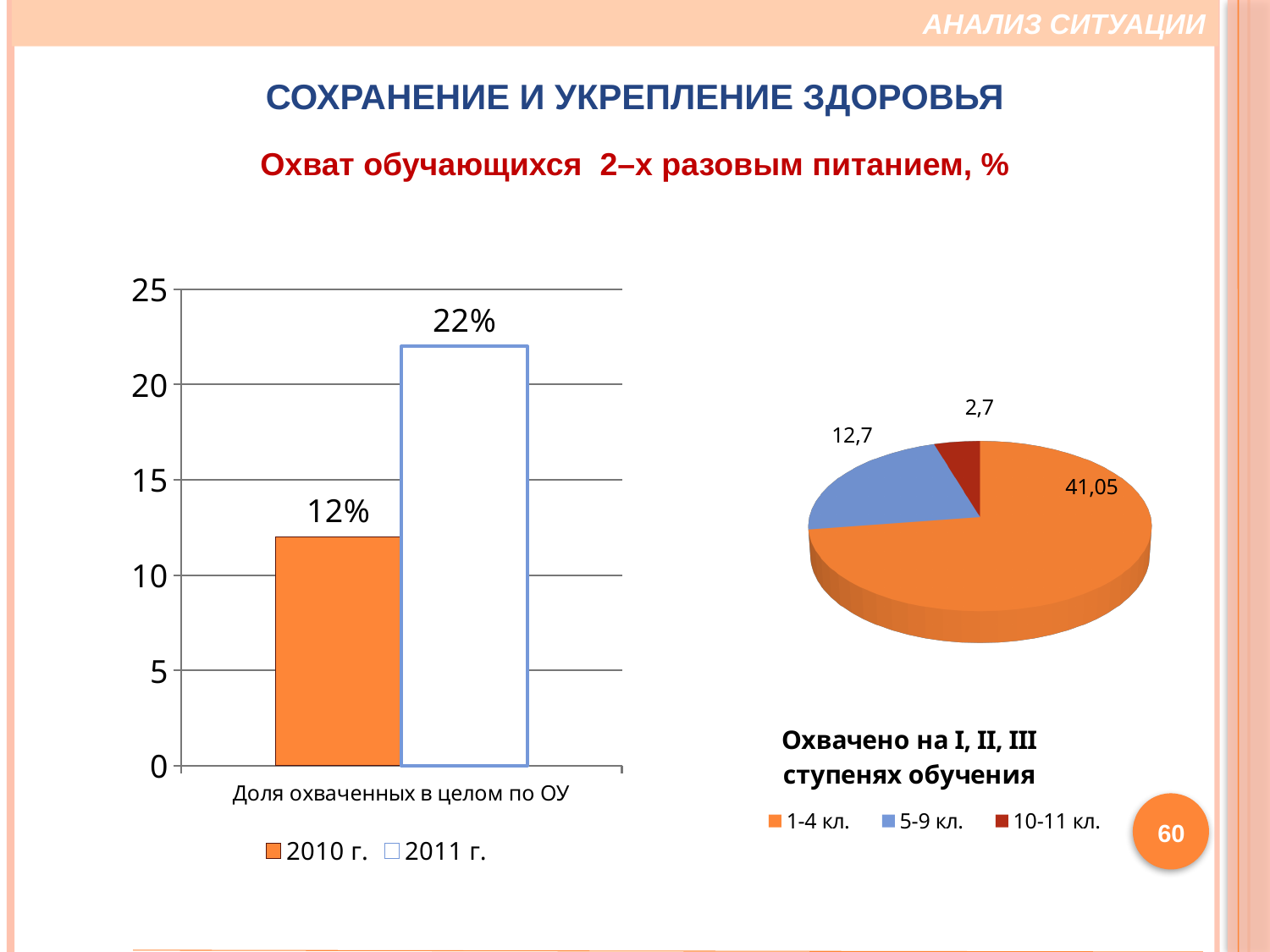
What kind of chart is the left chart? bar chart On the right pie chart, what is the value for 1-4 кл.? 41,05 On the left chart, what is the category label on the x axis? Доля охваченных в целом по ОУ On the left chart, what is the difference between the 2011 г. and 2010 г. values? 10% On the left chart, which series has the higher value, 2010 г. or 2011 г.? 2011 г. On the right pie chart, which category has the smallest slice? 10-11 кл. On the right pie chart, what is the difference between the values for 5-9 кл. and 10-11 кл.? 10 On the right pie chart, what is the value for 5-9 кл.? 12,7 On the left chart, how many series does the legend list? 2 What kind of chart is the right chart? pie chart On the left chart, what is the value for 2010 г.? 12% On the left chart, what is the value for 2011 г.? 22%